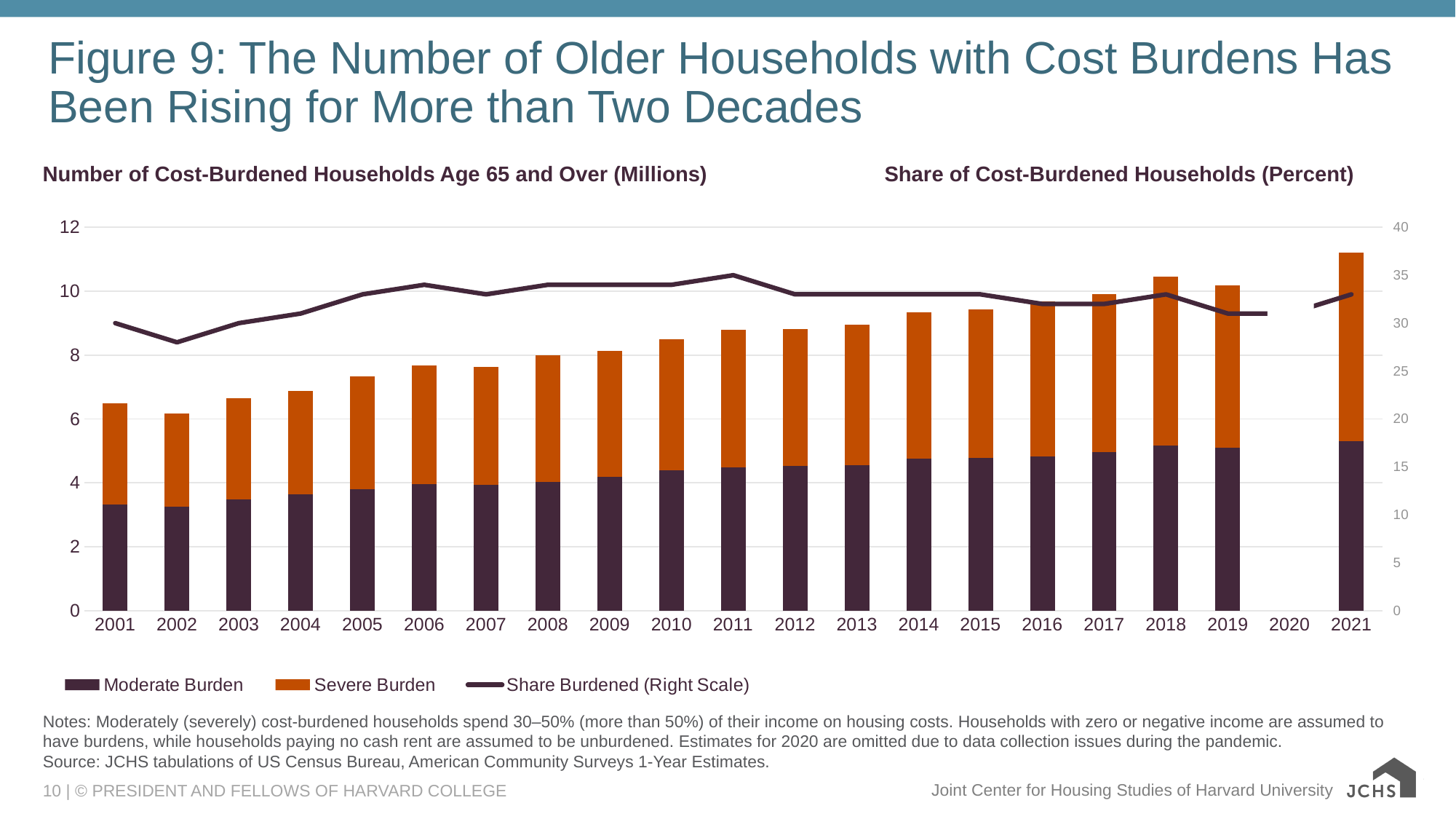
Is the total number of cost-burdened households in 2021 greater or less than 10 million? greater Which year has the tallest stacked bar for the number of cost-burdened households age 65 and over? 2021 How many series does the legend list? 3 What kind of chart is shown on the slide? Stacked bar chart with a line Which year has the larger total number of cost-burdened households, 2019 or 2021? 2021 In which year does the Share Burdened line reach its highest point? 2011 Which year has the shortest stacked bar for the number of cost-burdened households age 65 and over? 2002 Is the total number of cost-burdened households in 2015 greater or less than 10 million? less In which year does the Share Burdened line reach its lowest point? 2002 Does the total number of cost-burdened households generally rise or fall from 2001 to 2021? rise Is the total number of cost-burdened households in 2001 greater or less than 8 million? less